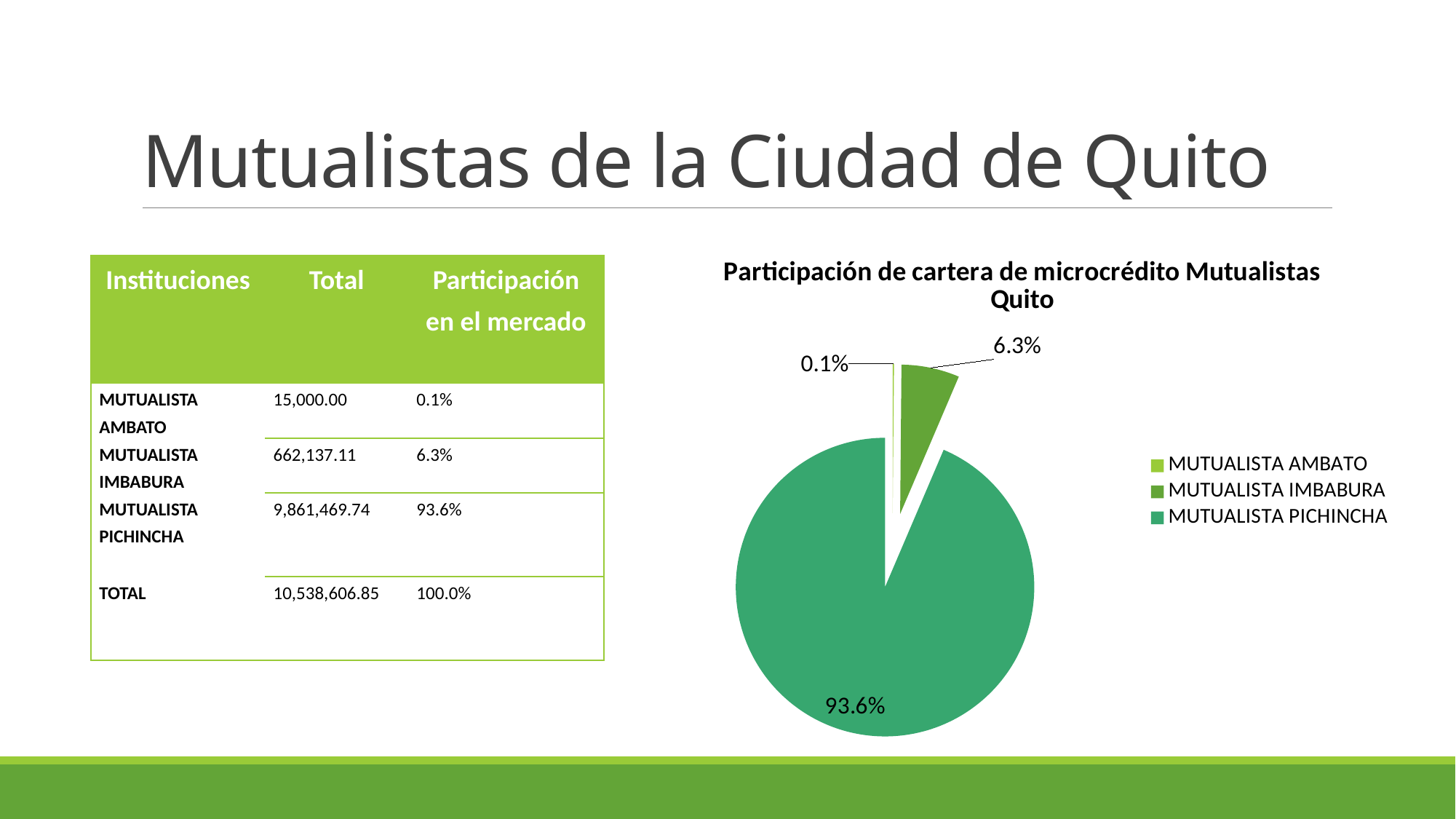
What is the title of the chart? Participación de cartera de microcrédito Mutualistas Quito Which slice is larger, MUTUALISTA IMBABURA or MUTUALISTA AMBATO? MUTUALISTA IMBABURA What is the difference in percentage points between the MUTUALISTA PICHINCHA slice and the MUTUALISTA IMBABURA slice? 87.3 What share of the pie does MUTUALISTA IMBABURA hold? 6.3% How many entries does the legend list? 3 Which institution has the largest slice of the pie? MUTUALISTA PICHINCHA What share of the pie does MUTUALISTA AMBATO hold? 0.1% Which institution has the smallest slice of the pie? MUTUALISTA AMBATO What share of the pie does MUTUALISTA PICHINCHA hold? 93.6% Which legend entry is shown in the lightest green colour? MUTUALISTA AMBATO What kind of chart is shown on the slide? Pie chart How many slices does the pie chart have? 3